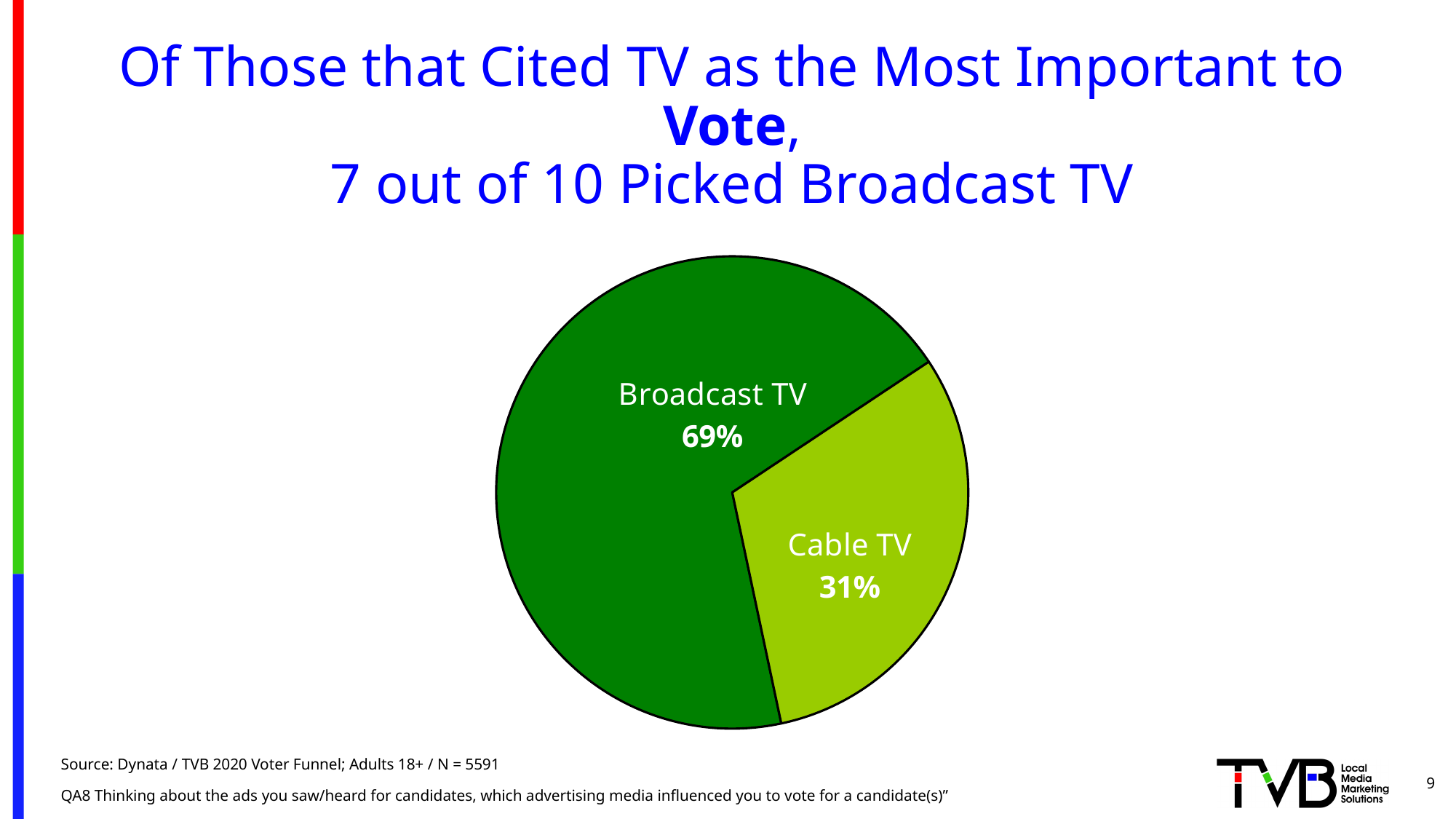
What is the difference in percentage points between Broadcast TV and Cable TV? 38 What percentage of the pie is Cable TV? 31% What colour is the Broadcast TV slice? dark green Which slice of the pie is the smallest? Cable TV What share of the pie does Cable TV represent? 31% Which is larger, the Broadcast TV slice or the Cable TV slice? Broadcast TV What kind of chart is shown on the slide? pie chart Which slice of the pie is the largest? Broadcast TV What percentage of the pie is Broadcast TV? 69% What is the source cited below the chart? Dynata / TVB 2020 Voter Funnel; Adults 18+ / N = 5591 What is the total of the two pie slices? 100% How many slices does the pie chart have? 2